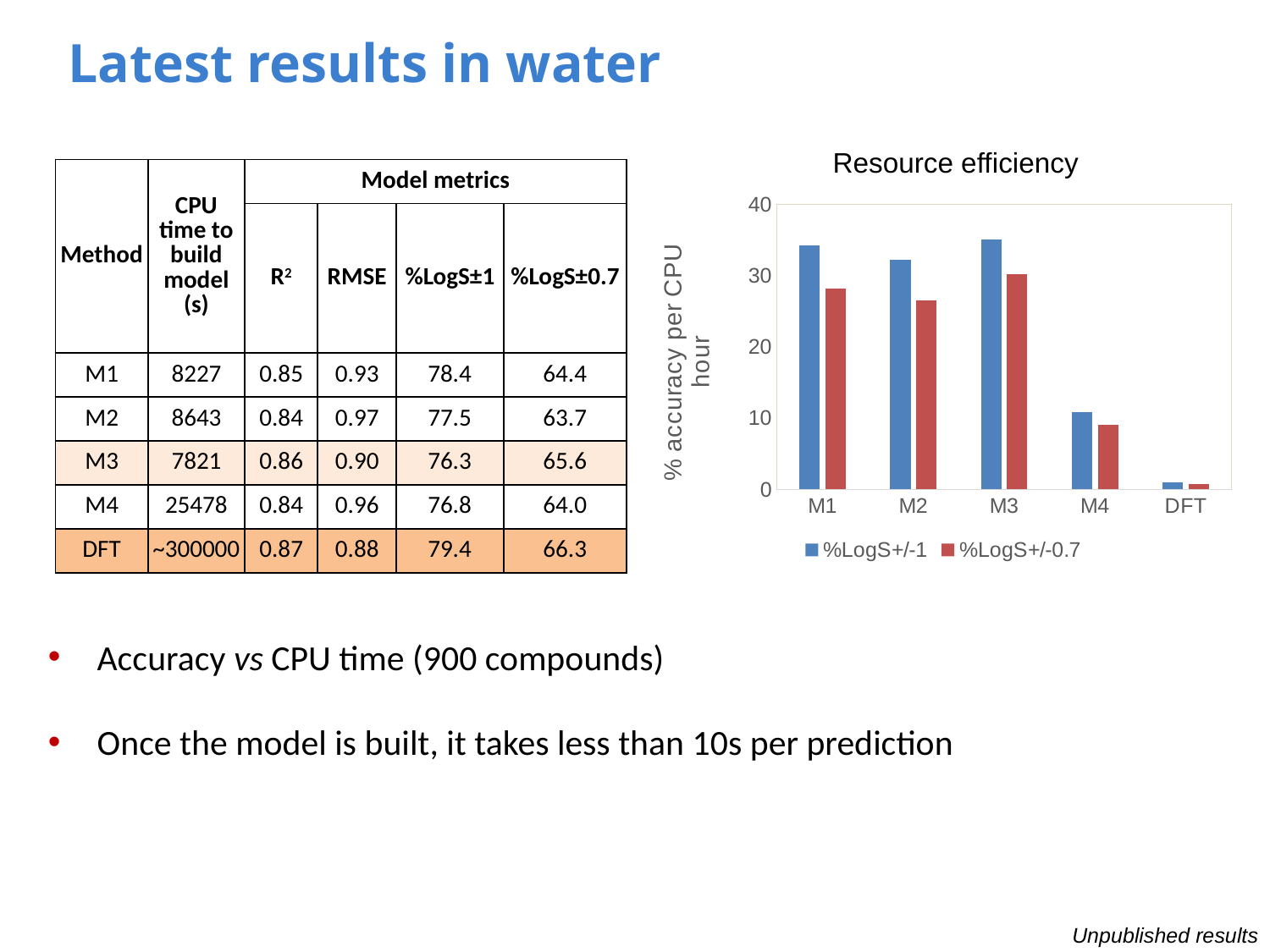
In the "Resource efficiency" chart, which method has the lowest %LogS+/-1 value? DFT In the "Resource efficiency" chart, is the %LogS+/-0.7 value for M2 greater or less than 30? less What is the y-axis label of the "Resource efficiency" chart? % accuracy per CPU hour How many methods are shown on the x axis of the "Resource efficiency" chart? 5 In the "Resource efficiency" chart, which method has the highest %LogS+/-0.7 value? M3 What kind of chart is the "Resource efficiency" chart? bar chart Which series in the "Resource efficiency" chart is shown in red? %LogS+/-0.7 In the "Resource efficiency" chart, do the %LogS+/-1 values rise or fall from M3 to DFT? fall How many series does the legend of the "Resource efficiency" chart list? 2 In the "Resource efficiency" chart, which is larger: the %LogS+/-1 value for M1 or for M4? M1 In the "Resource efficiency" chart, is the %LogS+/-1 value for M1 greater or less than 30? greater In the "Resource efficiency" chart, is the %LogS+/-1 value for DFT greater or less than 10? less